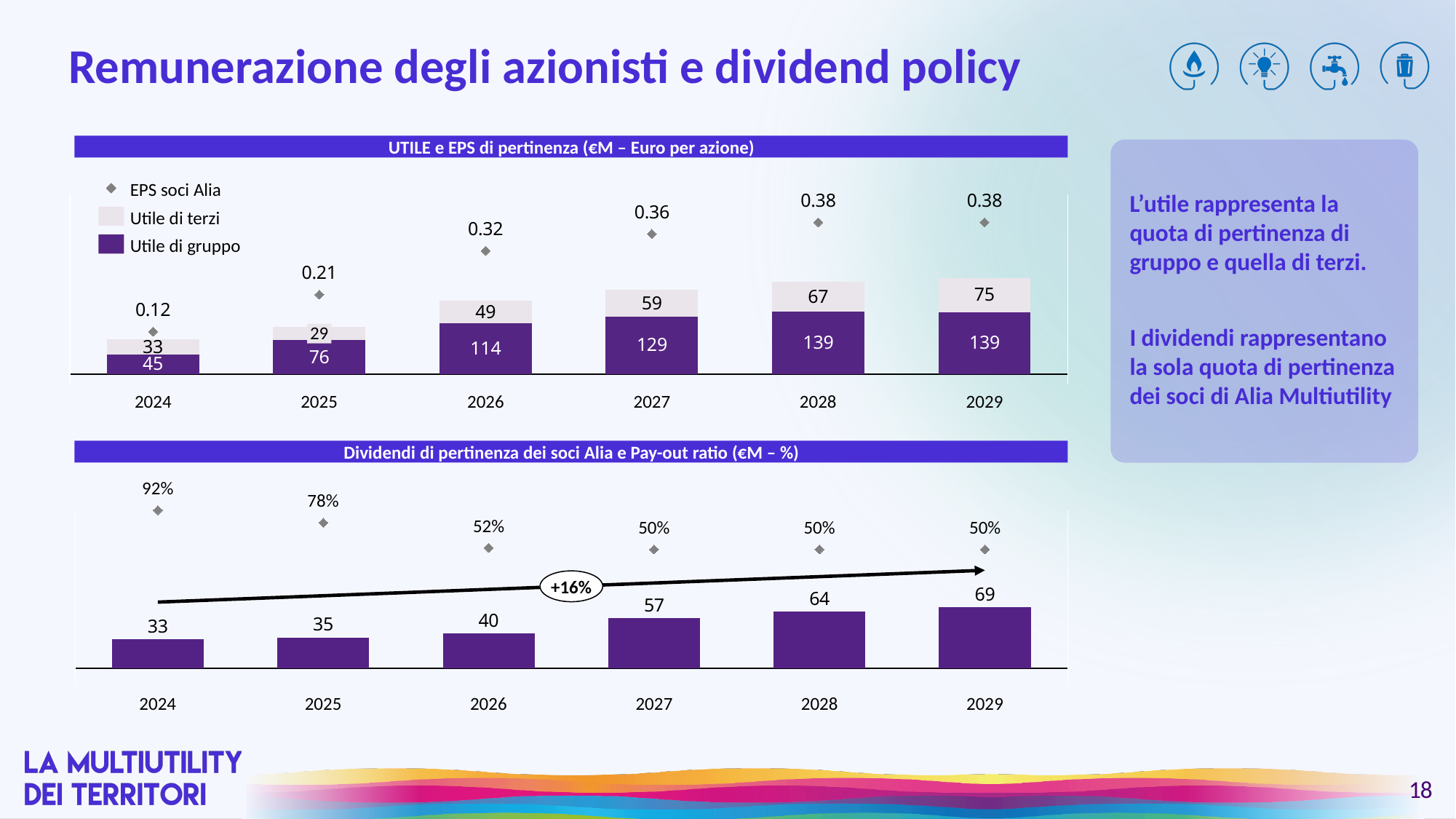
In the chart titled 'Dividendi di pertinenza dei soci Alia e Pay-out ratio', how many years are shown on the x axis? 6 In the chart titled 'Dividendi di pertinenza dei soci Alia e Pay-out ratio', what is the pay-out ratio for 2024? 92% In the chart titled 'UTILE e EPS di pertinenza', which year has the lowest Utile di gruppo value? 2024 In the chart titled 'Dividendi di pertinenza dei soci Alia e Pay-out ratio', what is the dividend value for 2028? 64 In the chart titled 'UTILE e EPS di pertinenza', what is the EPS soci Alia value for 2026? 0.32 In the chart titled 'UTILE e EPS di pertinenza', what is the Utile di terzi value for 2029? 75 In the chart titled 'UTILE e EPS di pertinenza', how many series does the legend list? 3 In the chart titled 'Dividendi di pertinenza dei soci Alia e Pay-out ratio', what is the difference between the dividend values for 2029 and 2024? 36 In the chart titled 'UTILE e EPS di pertinenza', what is the total of the stacked bar for 2026? 163 In the chart titled 'UTILE e EPS di pertinenza', what is the Utile di gruppo value for 2027? 129 In the chart titled 'Dividendi di pertinenza dei soci Alia e Pay-out ratio', do the dividend values rise or fall from 2024 to 2029? rise What kind of chart is the chart titled 'Dividendi di pertinenza dei soci Alia e Pay-out ratio'? bar chart